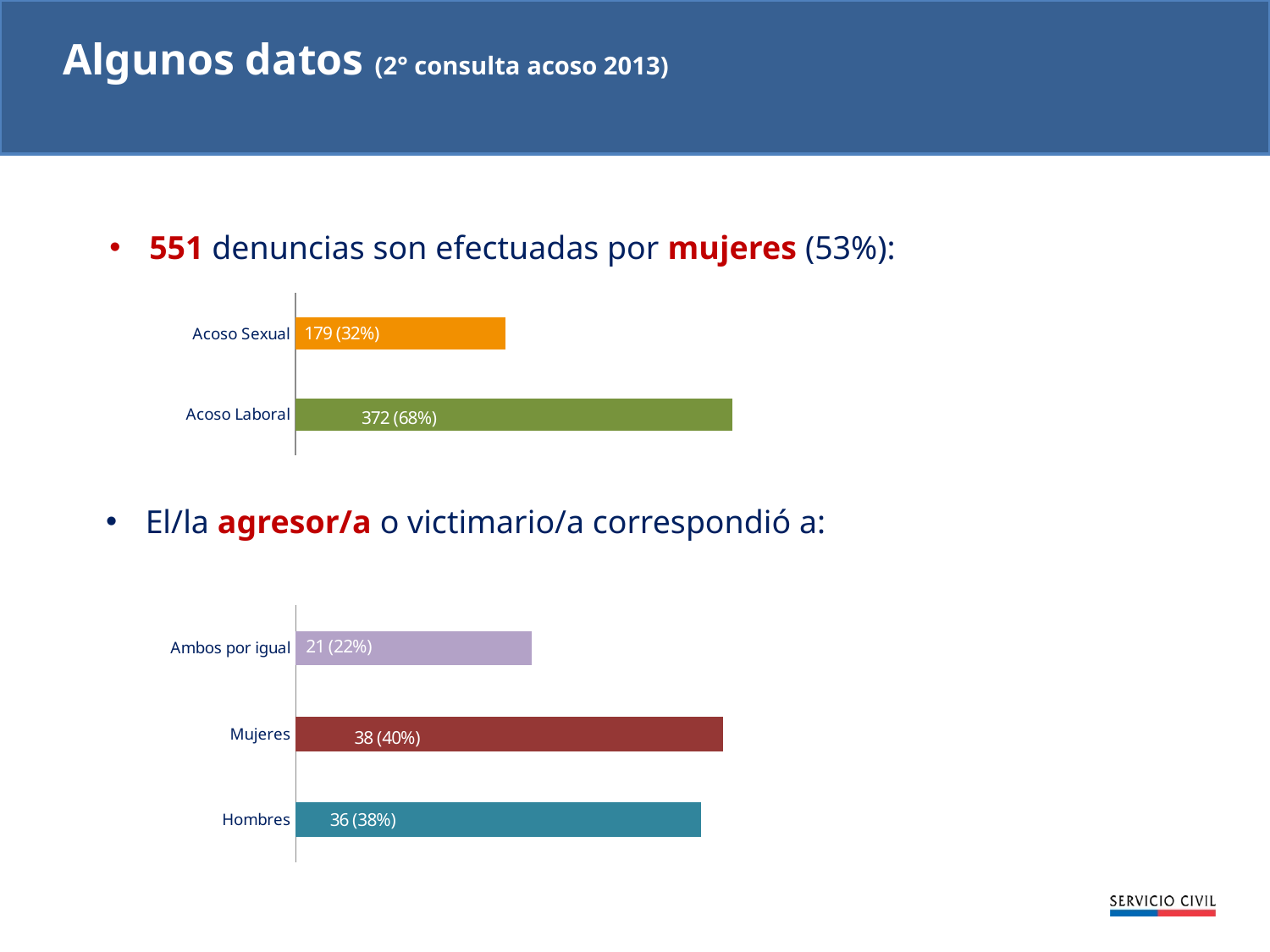
In the bottom chart (agresor/a o victimario/a), what is the data label for Ambos por igual? 21 (22%) In the top chart (denuncias por mujeres), what is the data label for Acoso Laboral? 372 (68%) In the bottom chart (agresor/a o victimario/a), what is the data label for Mujeres? 38 (40%) In the top chart (denuncias por mujeres), how many categories are shown? 2 In the bottom chart (agresor/a o victimario/a), how many categories are shown? 3 In the bottom chart (agresor/a o victimario/a), what is the data label for Hombres? 36 (38%) What type of chart is the bottom chart (agresor/a o victimario/a)? Bar chart In the top chart (denuncias por mujeres), what is the data label for Acoso Sexual? 179 (32%) In the bottom chart (agresor/a o victimario/a), which category has the lowest value? Ambos por igual In the top chart (denuncias por mujeres), what is the difference in count between Acoso Laboral and Acoso Sexual? 193 In the top chart (denuncias por mujeres), which category has the higher value? Acoso Laboral In the bottom chart (agresor/a o victimario/a), what is the difference in count between Mujeres and Ambos por igual? 17